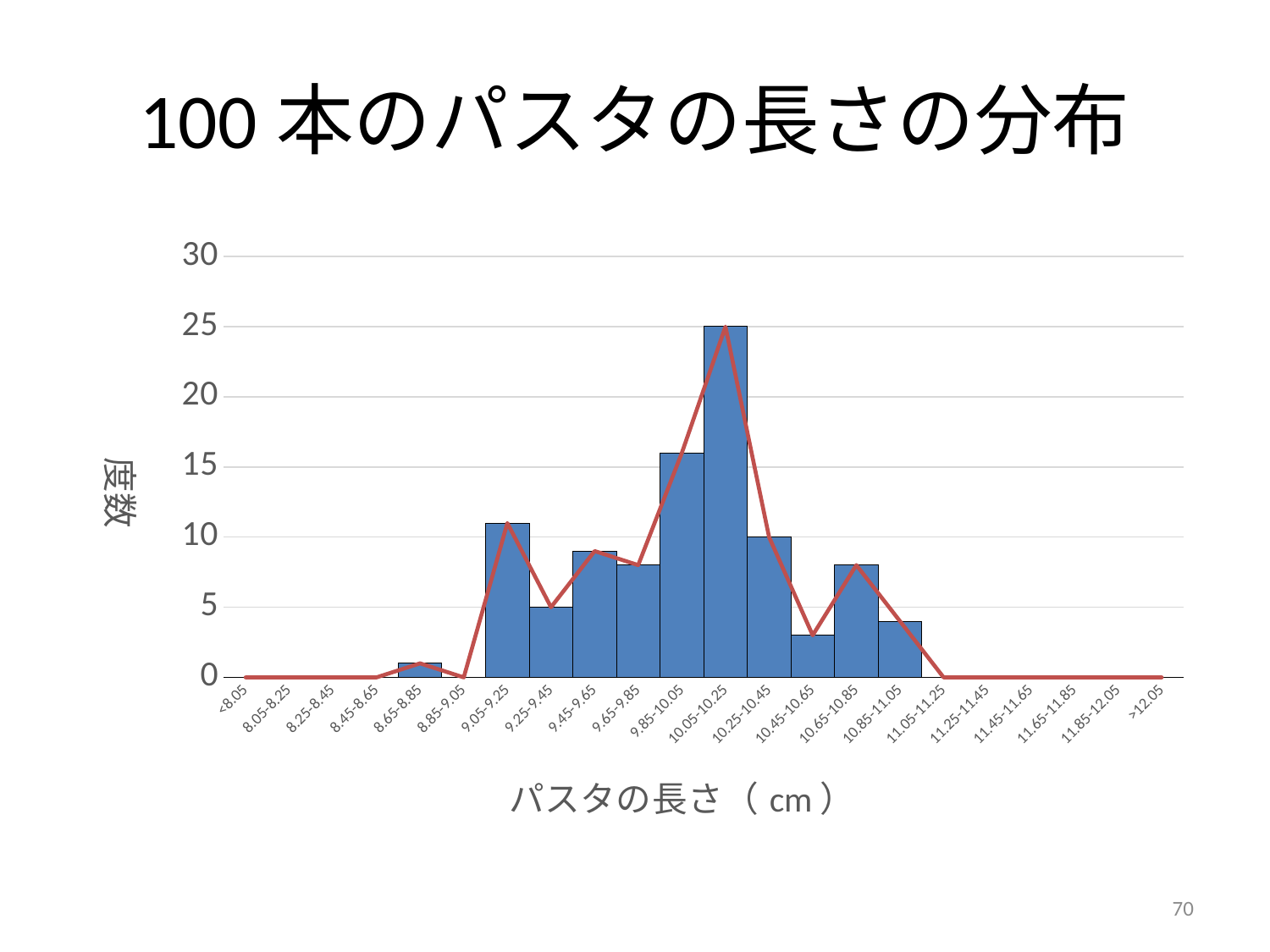
What kind of chart is shown on the slide? combination bar and line chart What is the frequency for the 9.25-9.45 range? 5 Is the frequency for the 9.85-10.05 range greater or less than 15? greater Which has a higher frequency, the 9.85-10.05 range or the 10.25-10.45 range? 9.85-10.05 Is the frequency for the 8.65-8.85 range greater or less than 5? less How many length ranges are shown on the x axis? 22 What is the frequency for the 11.25-11.45 range? 0 What is the frequency for the 10.05-10.25 range? 25 What is the difference in frequency between the 10.05-10.25 range and the 9.25-9.45 range? 20 Which length range has the highest frequency? 10.05-10.25 What is the frequency for the 10.25-10.45 range? 10 What is the label of the vertical axis? 度数